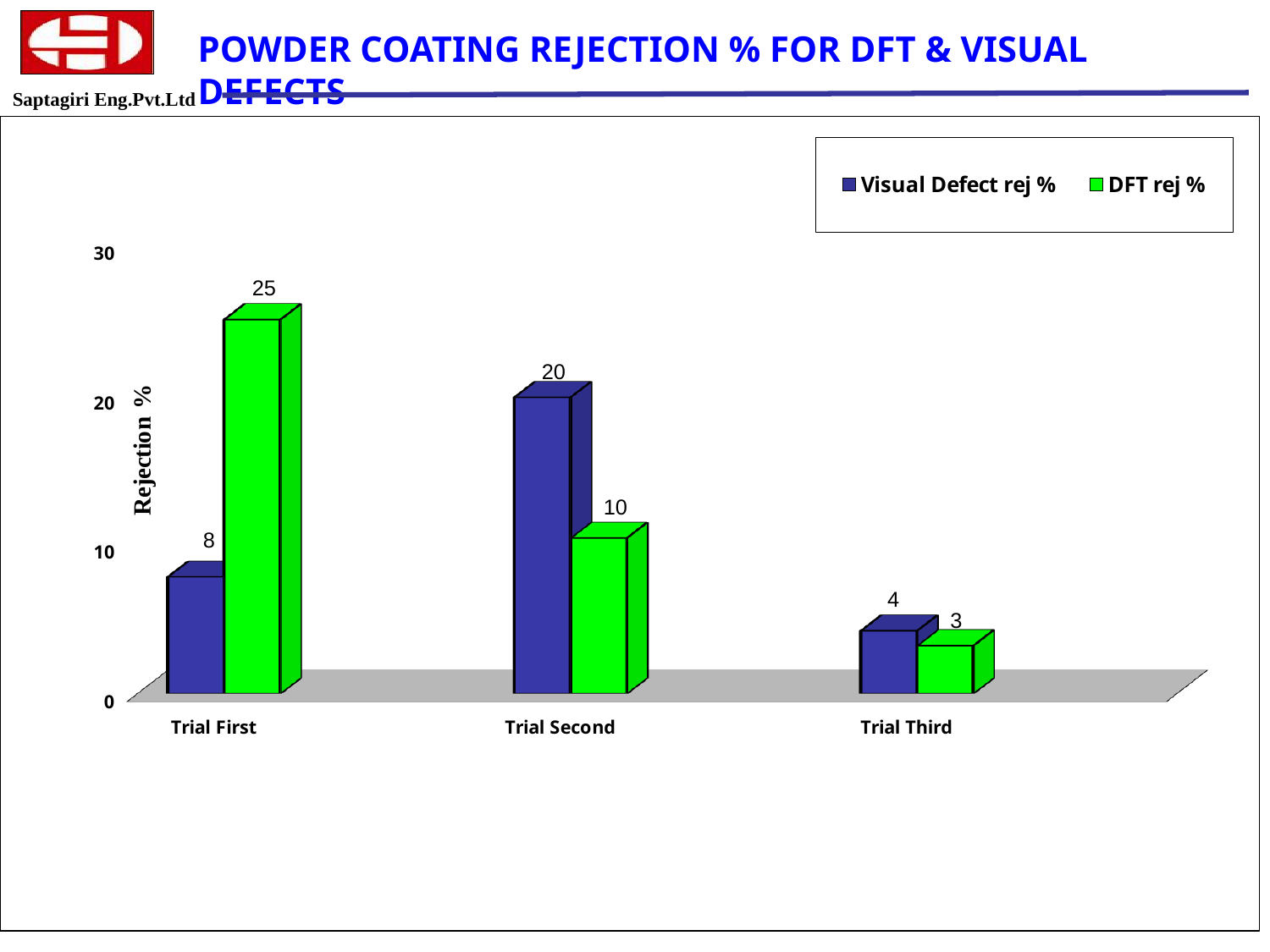
What is the DFT rej % value for Trial First? 25 Which trial has the lowest Visual Defect rej % value? Trial Third How many series does the legend list? 2 Does the DFT rej % value rise or fall from Trial First to Trial Third? Fall What is the difference between the DFT rej % and Visual Defect rej % values for Trial First? 17 What kind of chart is shown on the slide? Bar chart For Trial Second, which is larger: Visual Defect rej % or DFT rej %? Visual Defect rej % How many trials are shown on the x axis? 3 Which trial has the highest DFT rej % value? Trial First What is the Visual Defect rej % value for Trial First? 8 What is the DFT rej % value for Trial Third? 3 What is the Visual Defect rej % value for Trial Second? 20